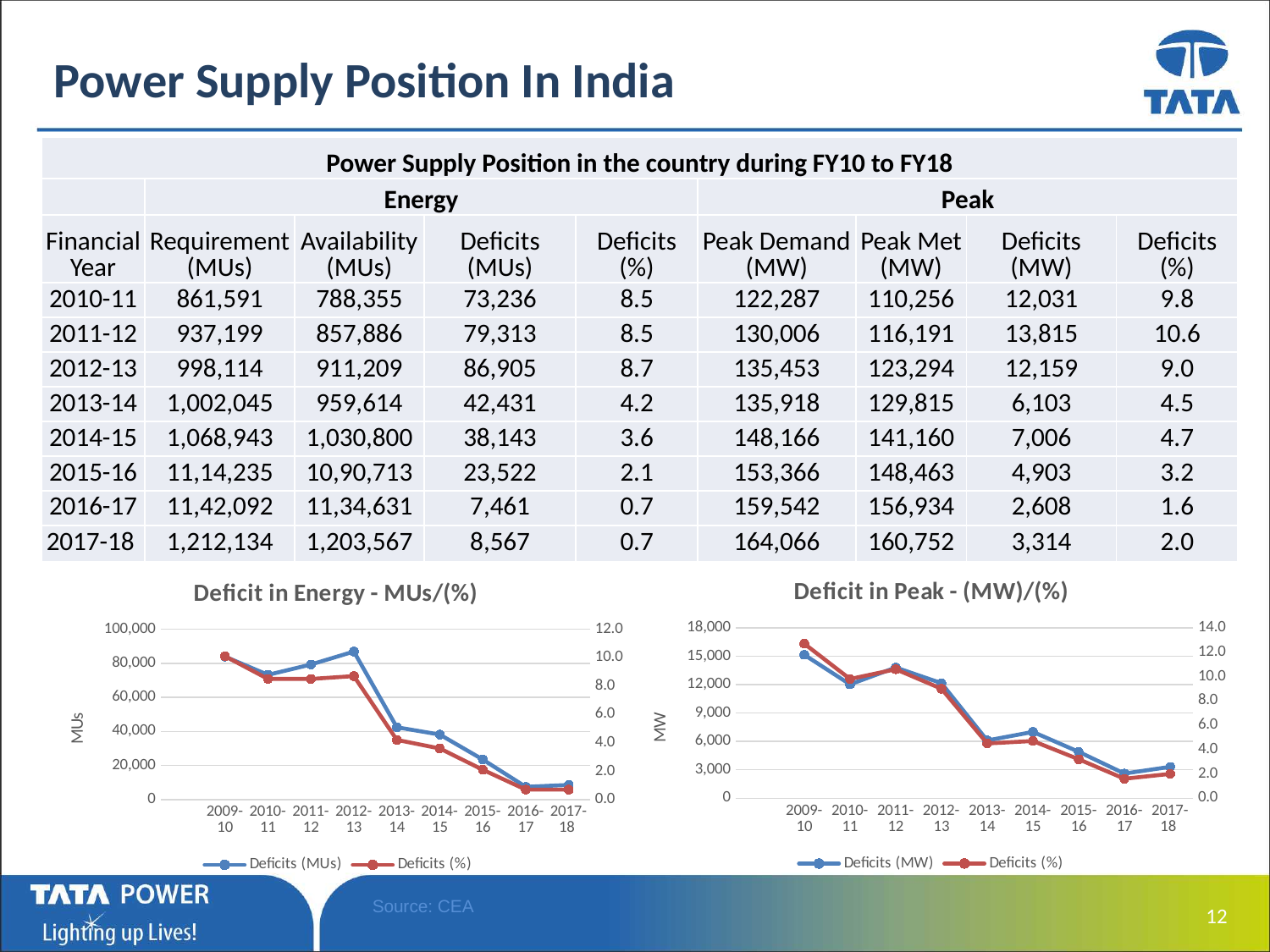
In the 'Deficit in Energy - MUs/(%)' chart, which series is drawn in red? Deficits (%) In the 'Deficit in Energy - MUs/(%)' chart, is the Deficits (MUs) value for 2016-17 greater or less than 20,000? less In the 'Deficit in Peak - (MW)/(%)' chart, do the Deficits (MW) values generally rise or fall from 2009-10 to 2017-18? fall In the 'Deficit in Energy - MUs/(%)' chart, is the Deficits (MUs) value for 2012-13 greater or less than 80,000? greater How many financial years are plotted along the x axis of the 'Deficit in Energy - MUs/(%)' chart? 9 In the 'Deficit in Energy - MUs/(%)' chart, is the Deficits (MUs) value for 2013-14 greater or less than 60,000? less What kind of chart is the 'Deficit in Energy - MUs/(%)' chart? line chart How many series does the legend of the 'Deficit in Peak - (MW)/(%)' chart list? 2 What is the label on the left vertical axis of the 'Deficit in Peak - (MW)/(%)' chart? MW